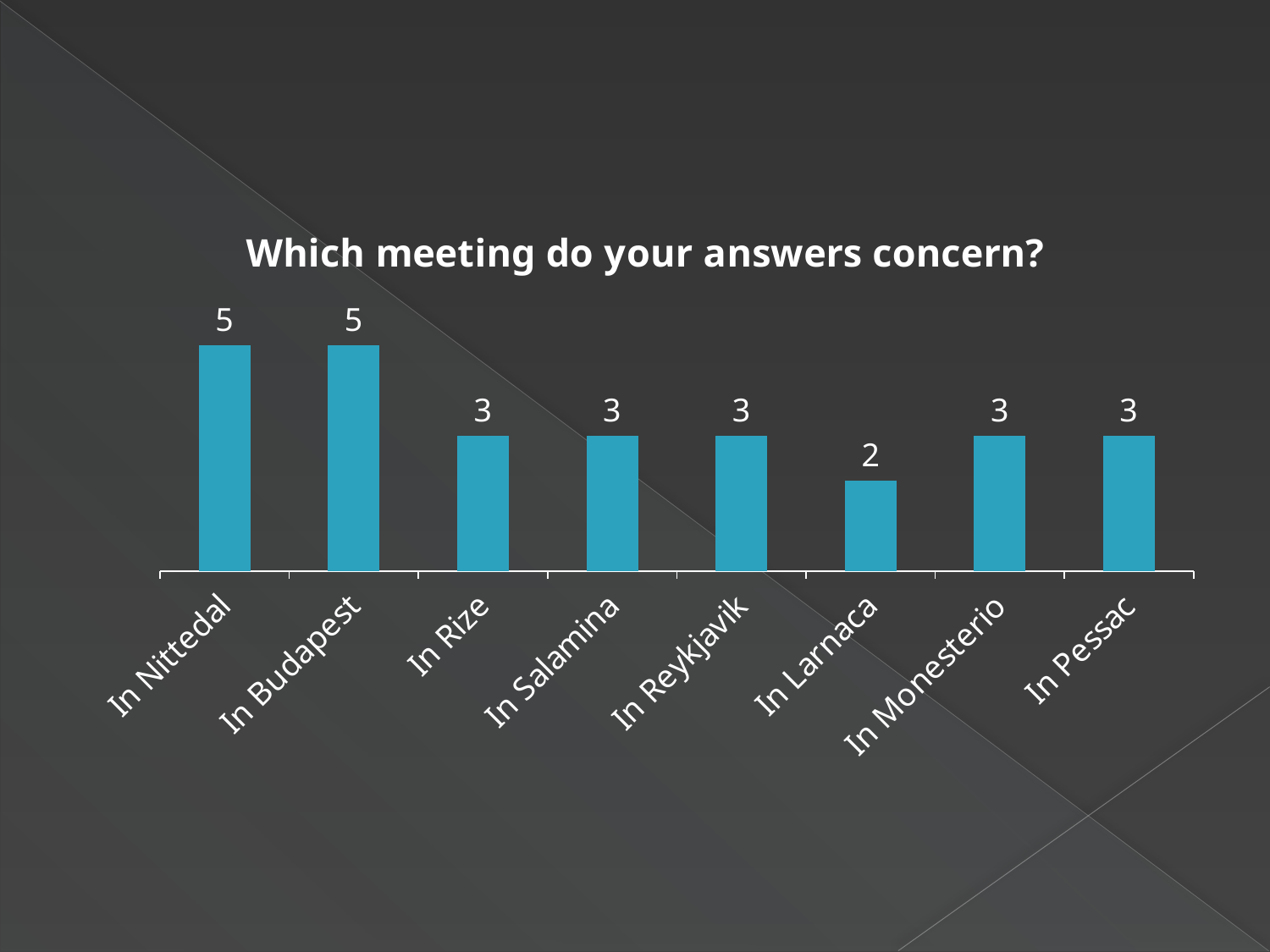
Which category has the lowest value? In Larnaca Which is larger, the value for In Salamina or the value for In Larnaca? In Salamina What is the title of the chart? Which meeting do your answers concern? What is the value for In Nittedal? 5 What is the value for In Pessac? 3 What is the value for In Larnaca? 2 What is the difference between the values for In Budapest and In Larnaca? 3 Which is larger, the value for In Budapest or the value for In Monesterio? In Budapest What kind of chart is shown on the slide? Bar chart How many categories are shown on the chart? 8 What is the value for In Reykjavik? 3 What is the difference between the values for In Nittedal and In Rize? 2